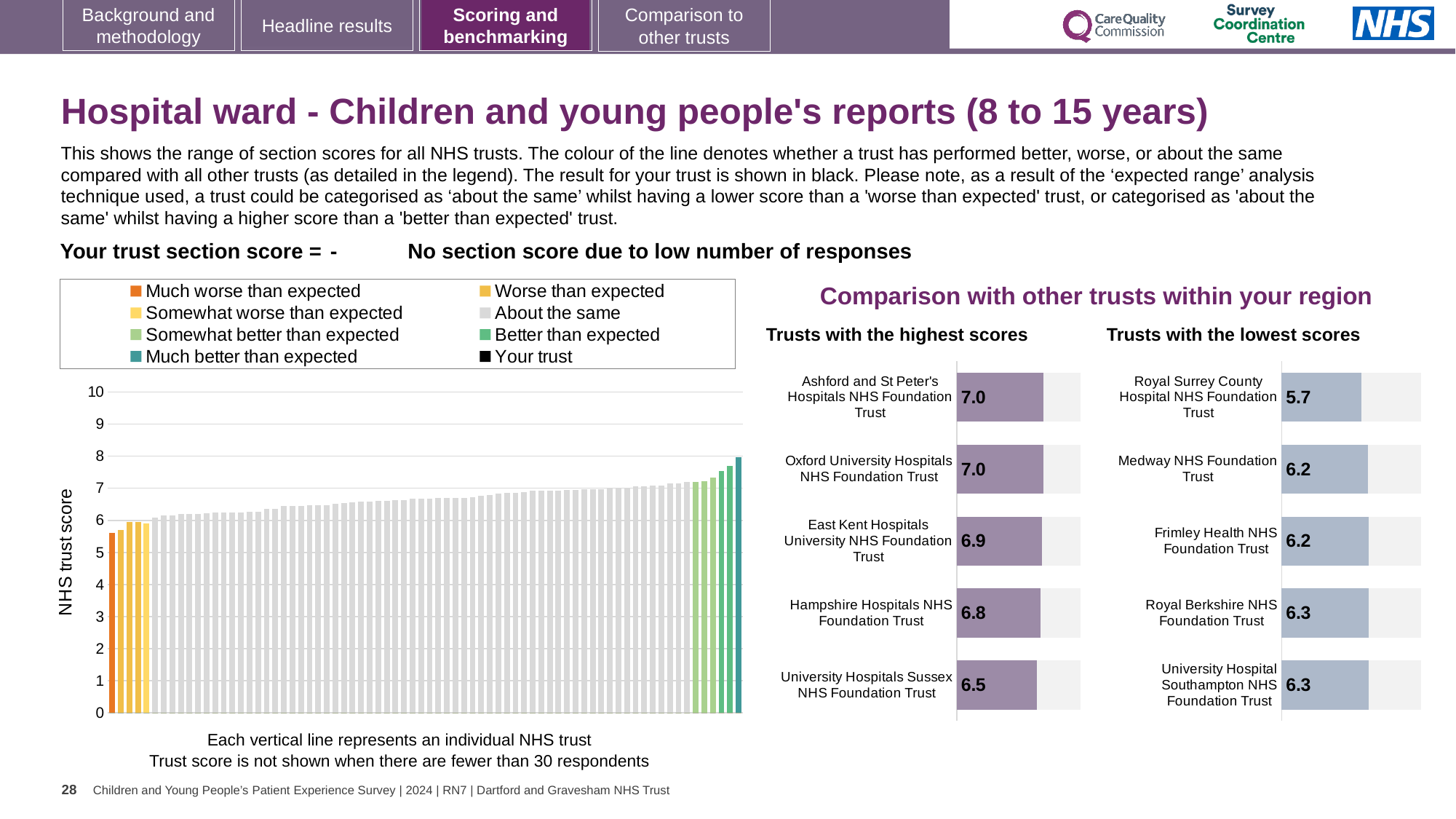
In the 'Trusts with the highest scores' chart, what is the score for East Kent Hospitals University NHS Foundation Trust? 6.9 How many trusts are listed in the 'Trusts with the highest scores' chart? 5 In the large 'NHS trust score' chart on the left, is the value of the tallest bar greater or less than 7? greater Which is larger: the score for Hampshire Hospitals NHS Foundation Trust in the highest scores chart, or the score for Frimley Health NHS Foundation Trust in the lowest scores chart? Hampshire Hospitals NHS Foundation Trust In the 'Trusts with the lowest scores' chart, which trust has the lowest score? Royal Surrey County Hospital NHS Foundation Trust In the 'Trusts with the lowest scores' chart, what is the score for Royal Surrey County Hospital NHS Foundation Trust? 5.7 In the large 'NHS trust score' chart on the left, do the bar values rise or fall from left to right? rise In the 'Trusts with the lowest scores' chart, what is the difference between the scores of Royal Berkshire NHS Foundation Trust and Royal Surrey County Hospital NHS Foundation Trust? 0.6 In the 'Trusts with the lowest scores' chart, what is the score for Medway NHS Foundation Trust? 6.2 In the 'Trusts with the highest scores' chart, what is the difference between the scores of Ashford and St Peter's Hospitals NHS Foundation Trust and University Hospitals Sussex NHS Foundation Trust? 0.5 In the 'Trusts with the highest scores' chart, which trust has the lowest score shown? University Hospitals Sussex NHS Foundation Trust In the 'Trusts with the highest scores' chart, what is the score for University Hospitals Sussex NHS Foundation Trust? 6.5